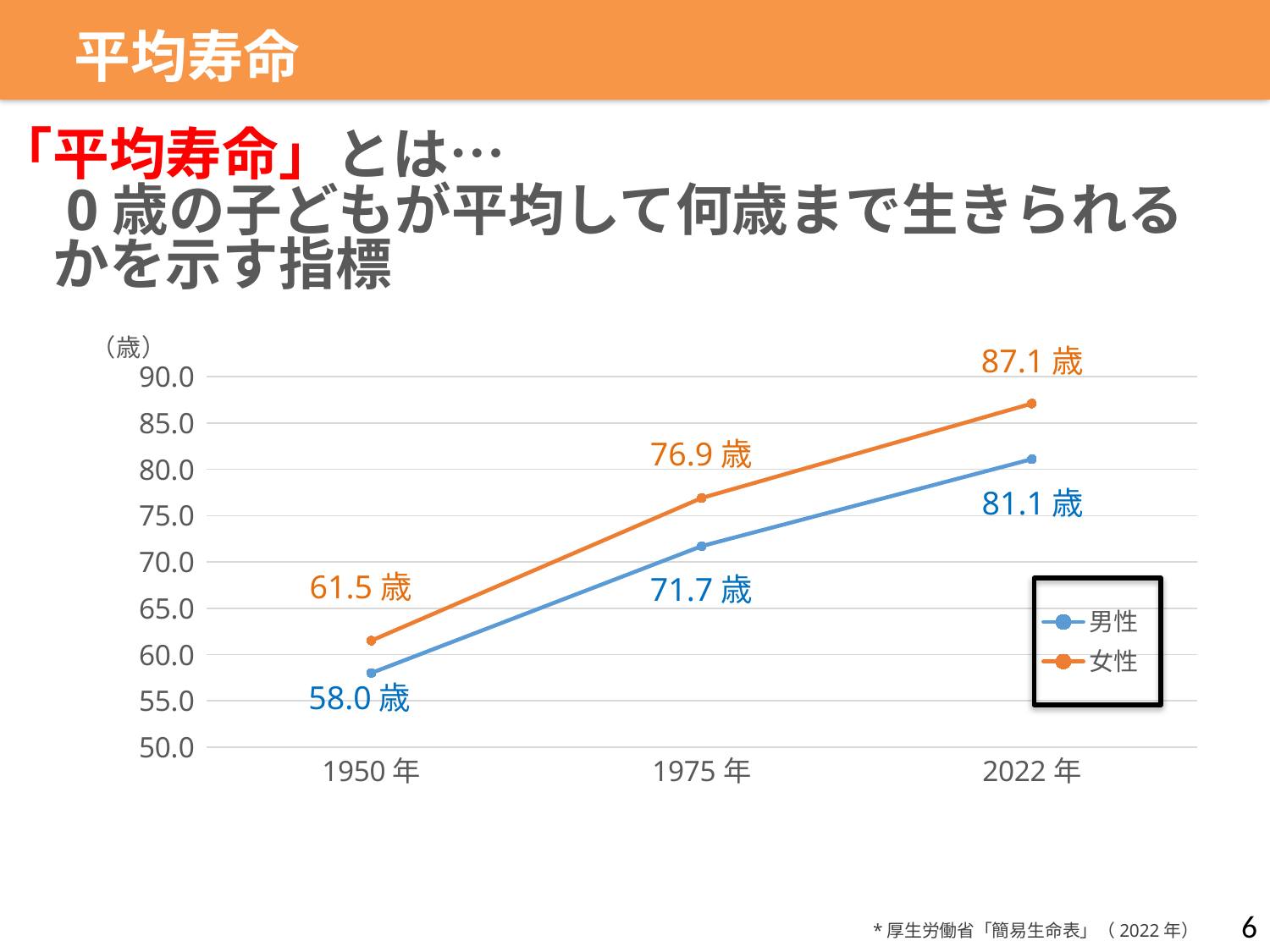
In which year is the value for 女性 highest? 2022年 How many series does the legend list? 2 What is the value for 女性 in 1975年? 76.9歳 What is the difference between 女性 and 男性 in 2022年? 6.0歳 What is the value for 男性 in 1950年? 58.0歳 What kind of chart is shown on the slide? line chart Which is larger in 1975年, 男性 or 女性? 女性 In which year is the value for 男性 lowest? 1950年 How many years are shown on the x axis? 3 What is the value for 男性 in 2022年? 81.1歳 What is the difference between the 男性 values in 1975年 and 1950年? 13.7歳 What is the value for 女性 in 2022年? 87.1歳